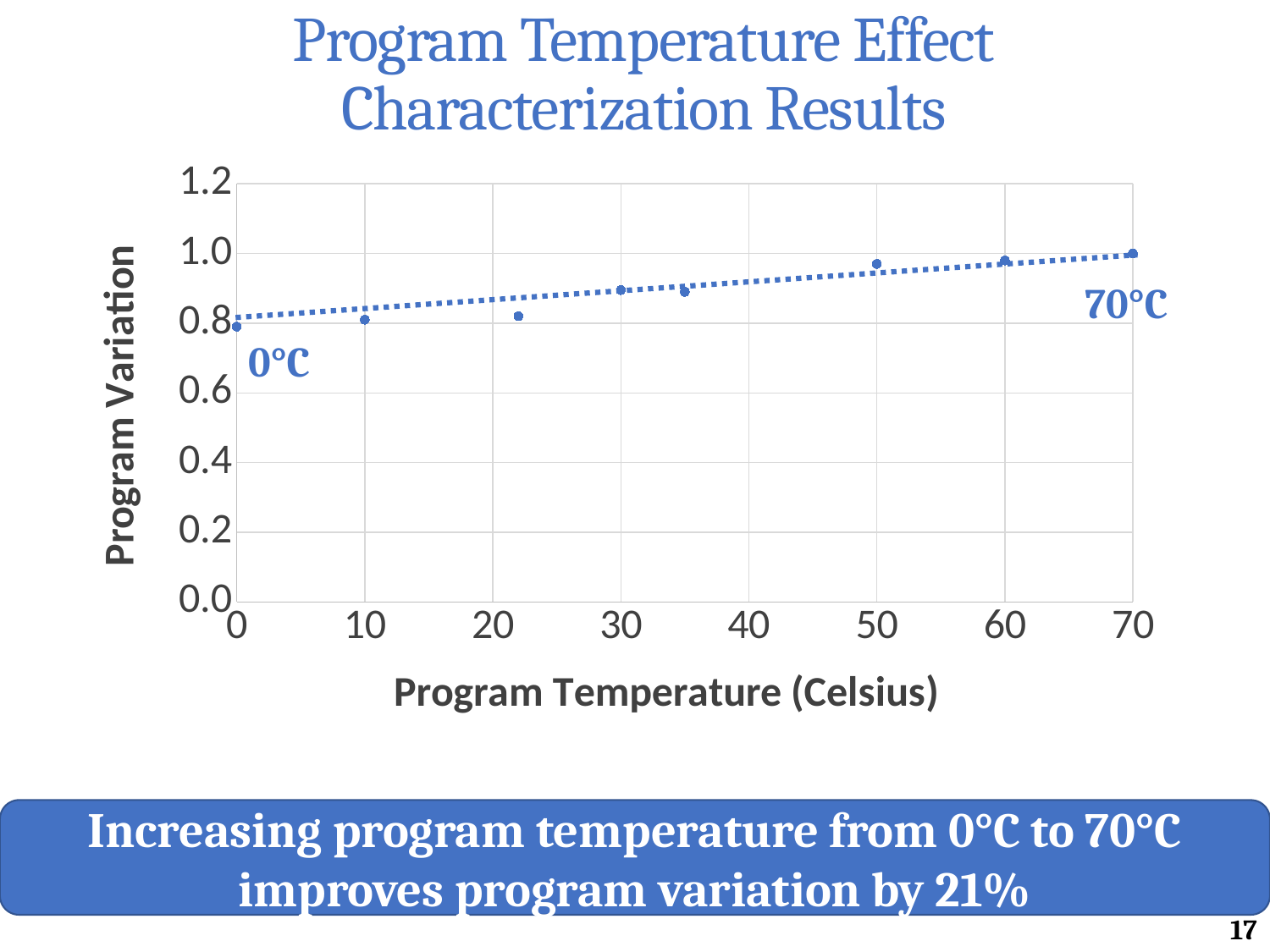
Which has the larger Program Variation value: the point at 0 degrees Celsius or the point at 70 degrees Celsius? 70 degrees Celsius Do the Program Variation values rise or fall as Program Temperature increases along the x axis? rise Is the Program Variation value at 50 degrees Celsius greater or less than 0.8? greater Is the Program Variation value at 10 degrees Celsius greater or less than 1.0? less Is the Program Variation value at 30 degrees Celsius greater or less than 0.6? greater What kind of chart is shown on the slide? scatter chart What is the title of the y axis? Program Variation What is the title of the x axis? Program Temperature (Celsius) How many data points are plotted on the chart? 8 Which has the larger Program Variation value: the point at 10 degrees Celsius or the point at 50 degrees Celsius? 50 degrees Celsius